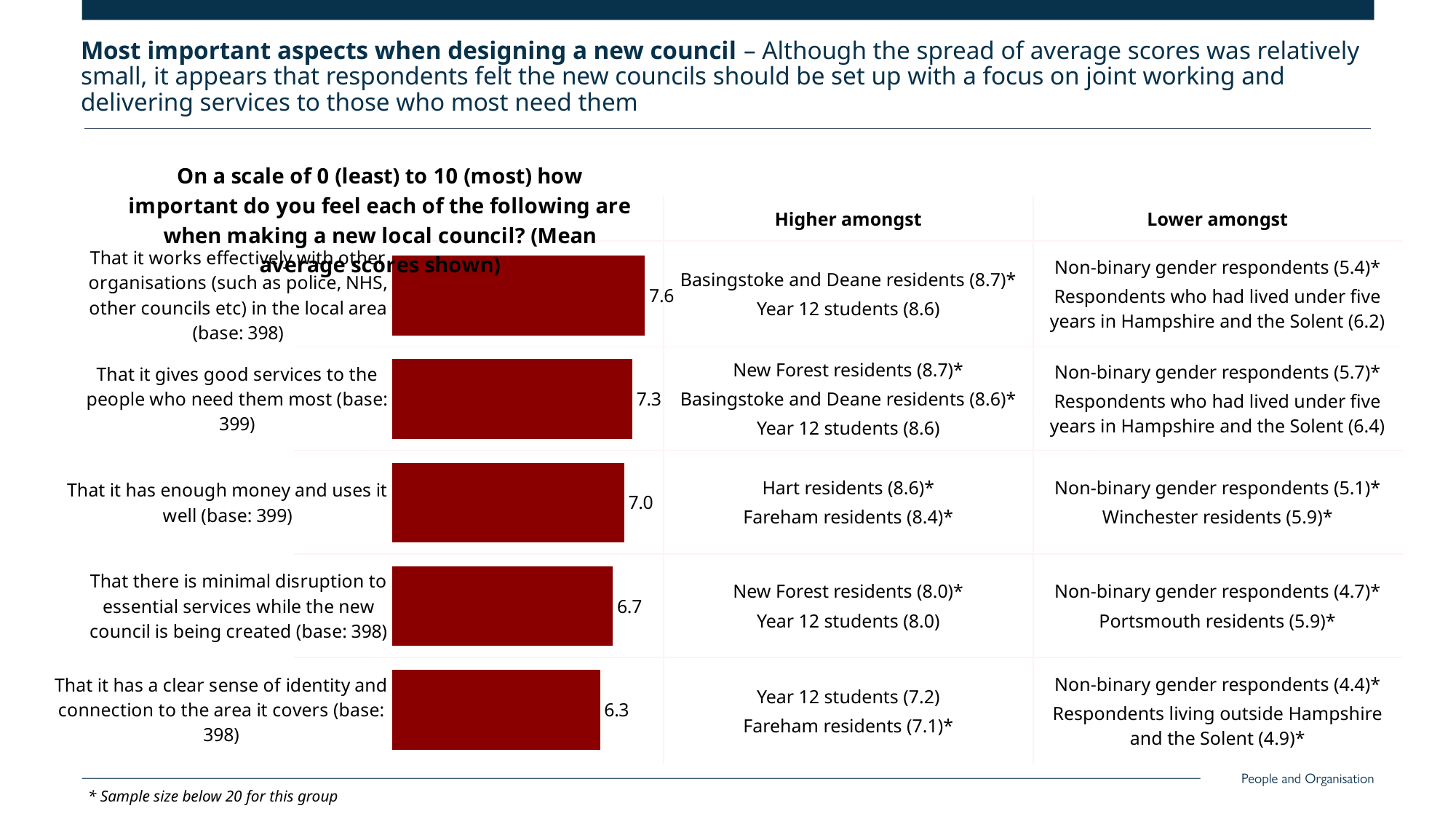
What is the difference between the mean scores for 'That it gives good services to the people who need them most' and 'That there is minimal disruption to essential services while the new council is being created'? 0.6 Which has a higher mean score: 'That it has enough money and uses it well' or 'That it has a clear sense of identity and connection to the area it covers'? That it has enough money and uses it well What is the mean average score for 'That it gives good services to the people who need them most'? 7.3 What is the mean average score for 'That it has a clear sense of identity and connection to the area it covers'? 6.3 Which aspect has the highest mean average score? That it works effectively with other organisations (such as police, NHS, other councils etc) in the local area What is the difference between the highest and lowest mean average scores shown in the chart? 1.3 Which aspect has the lowest mean average score? That it has a clear sense of identity and connection to the area it covers What is the mean average score for 'That it has enough money and uses it well'? 7.0 How many aspects are plotted in the bar chart? 5 What colour are the bars in the chart? Dark red What is the mean average score for 'That there is minimal disruption to essential services while the new council is being created'? 6.7 What type of chart is used to show the mean average scores? Bar chart